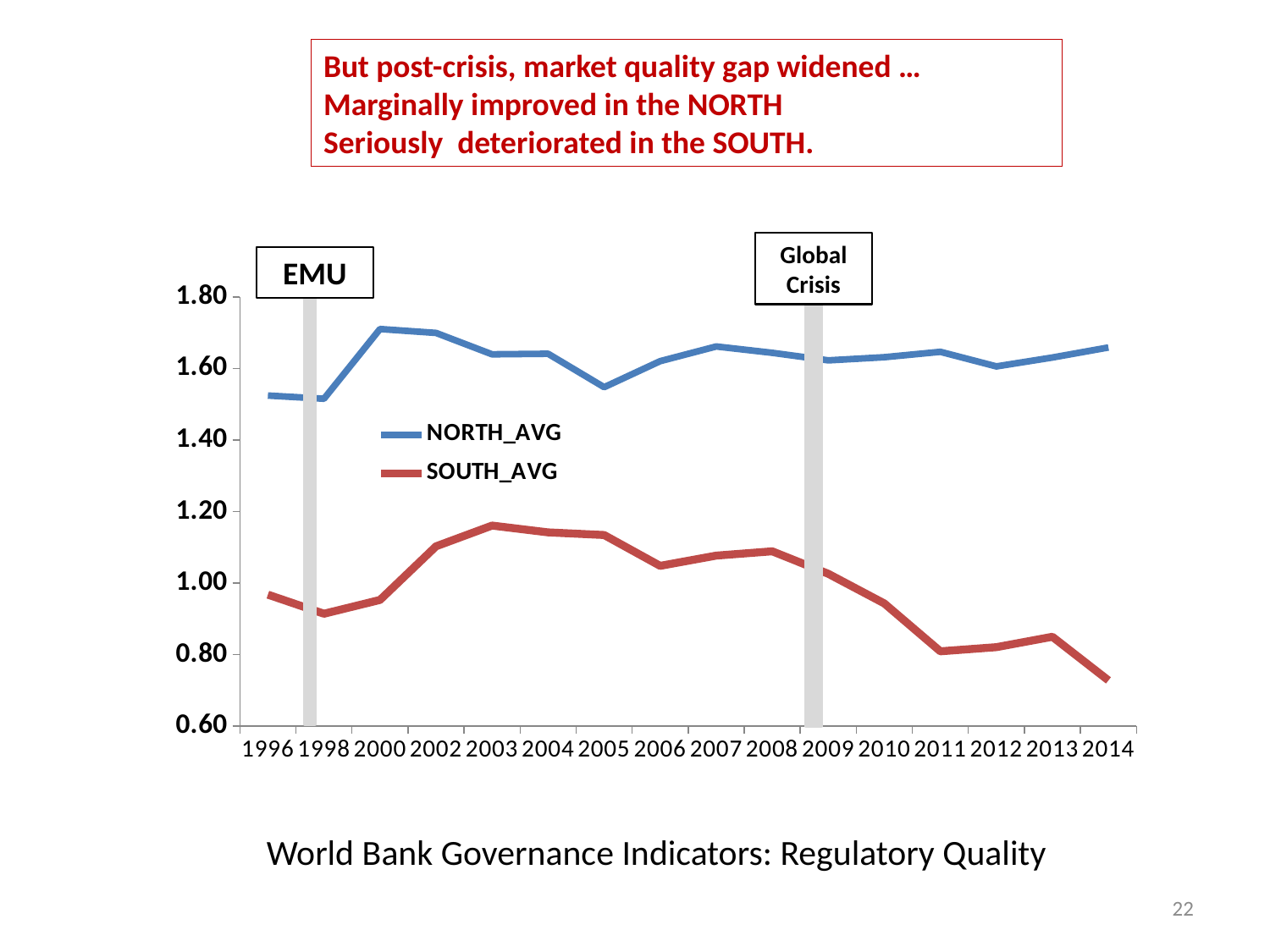
Is the NORTH_AVG value for 2005 greater or less than 1.60? less Is the NORTH_AVG value for 2000 greater or less than 1.60? greater Is the SOUTH_AVG value for 2003 greater or less than 1.00? greater How many years are shown on the x axis? 16 In 2014, which series has the higher value, NORTH_AVG or SOUTH_AVG? NORTH_AVG In which year is the SOUTH_AVG value lowest? 2014 Does the SOUTH_AVG line rise or fall from 2009 to 2014? fall How many series does the legend list? 2 What caption appears below the chart? World Bank Governance Indicators: Regulatory Quality What kind of chart is shown on the slide? Line chart Which is larger, the SOUTH_AVG value in 1996 or in 2014? 1996